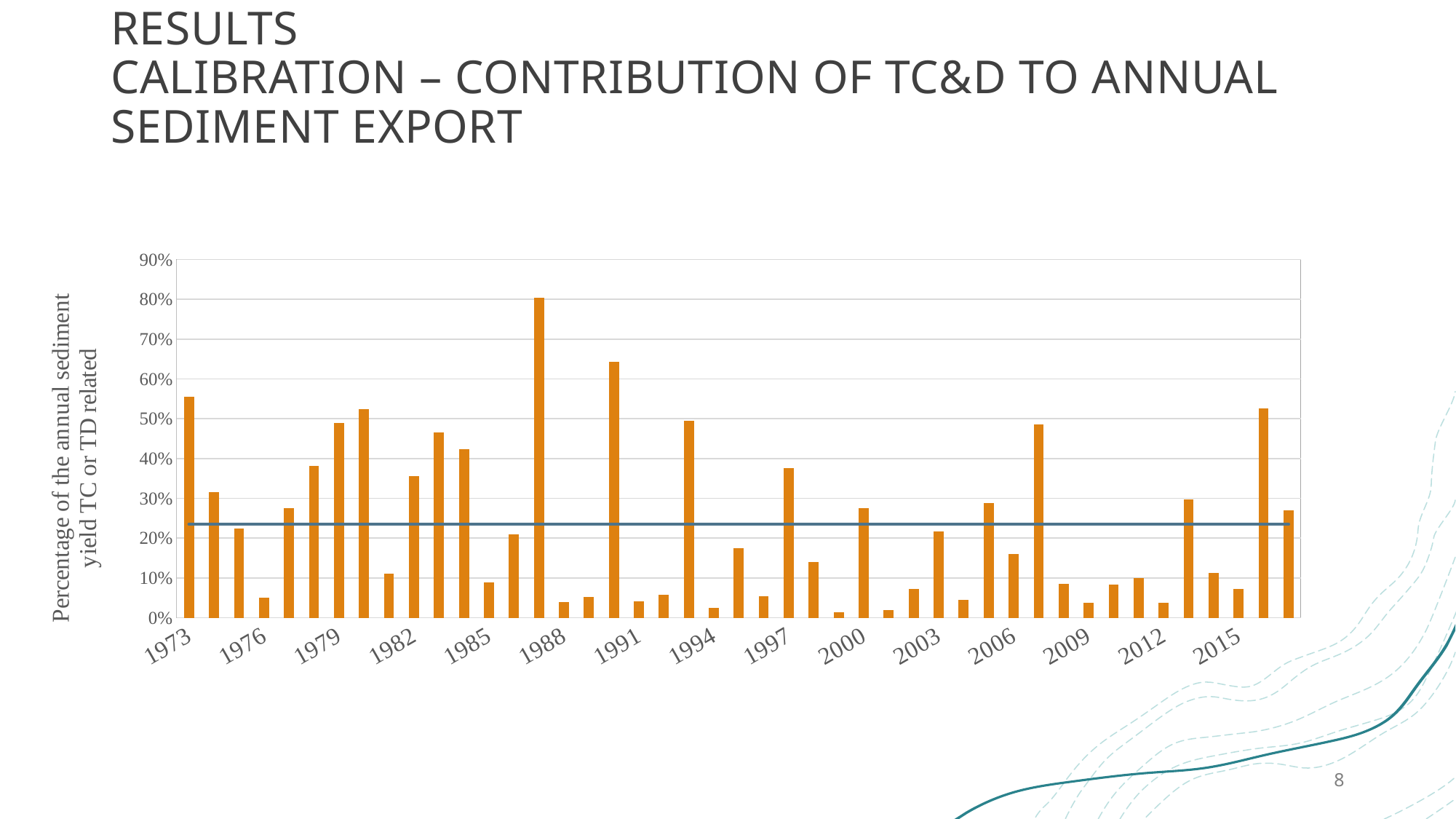
Is the value for 2015 greater or less than 10%? less Which year has the highest percentage of annual sediment yield that is TC or TD related? 1987 What kind of chart is shown on the slide? bar chart What is the title of the vertical axis? Percentage of the annual sediment yield TC or TD related Which year has the larger value, 1973 or 1976? 1973 Which year has the larger value, 1987 or 1991? 1987 Is the value for 1973 greater or less than 50%? greater Is the value for 1987 greater or less than 70%? greater How many year labels are shown on the x axis? 15 Which year has the larger value, 2006 or 2009? 2006